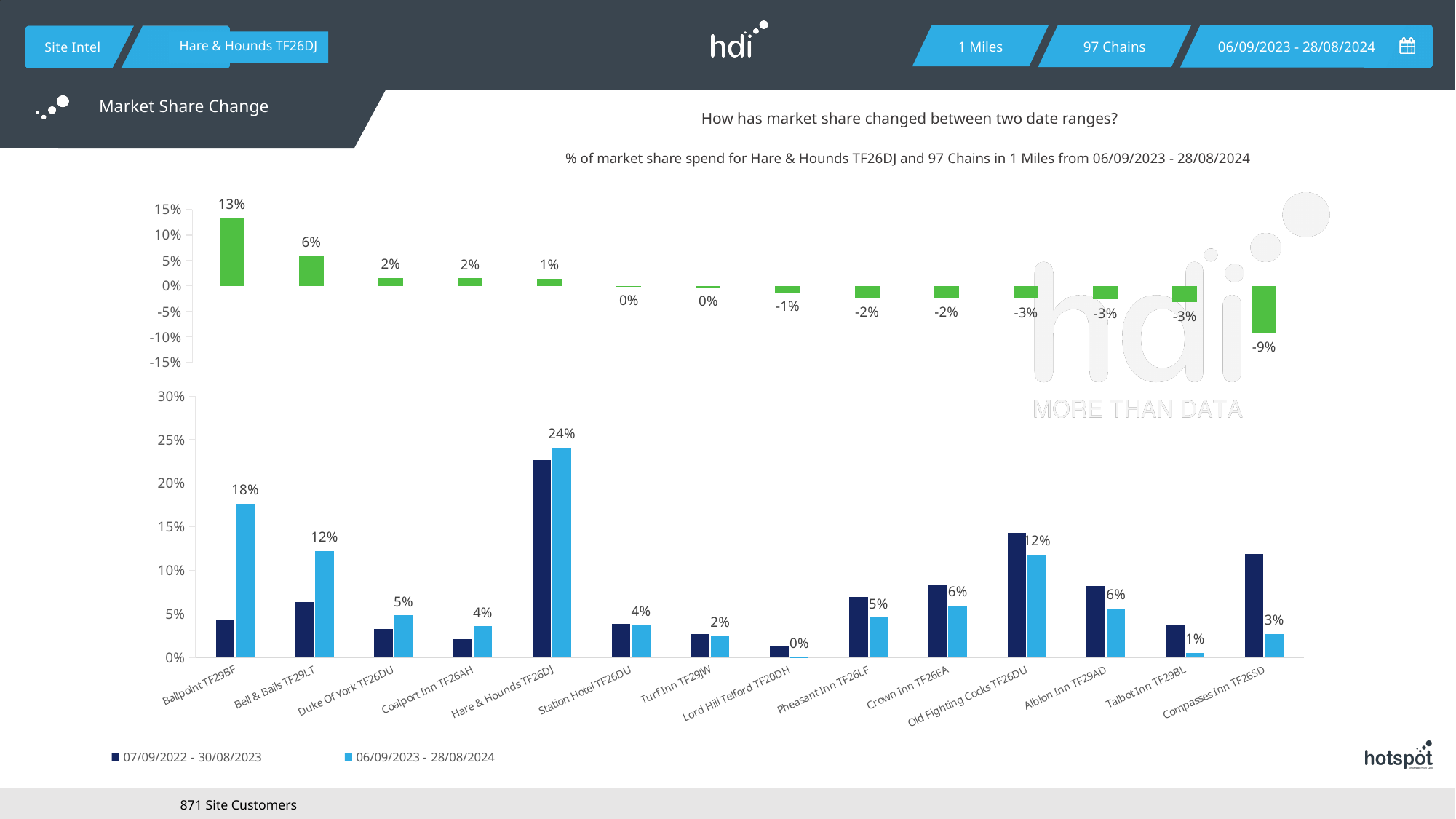
In the top chart (market share change), which category has the highest value? Ballpoint TF29BF How many categories are shown on the x axis of the bottom chart? 14 How many series does the legend of the bottom chart list? 2 In the bottom chart, is the value for Compasses Inn TF26SD in the 07/09/2022 - 30/08/2023 series greater or less than 10%? greater In the bottom chart, what is the value for Old Fighting Cocks TF26DU in the 06/09/2023 - 28/08/2024 series? 12% In the top chart (market share change), do the values rise or fall moving from left to right along the x axis? fall In the bottom chart, what is the value for Hare & Hounds TF26DJ in the 06/09/2023 - 28/08/2024 series? 24% In the bottom chart, which is larger in the 06/09/2023 - 28/08/2024 series: Ballpoint TF29BF or Bell & Bails TF29LT? Ballpoint TF29BF In the top chart (market share change), which category has the lowest value? Compasses Inn TF26SD In the top chart (market share change), what is the value for Ballpoint TF29BF? 13% What kind of chart is the bottom chart? bar chart In the top chart (market share change), what is the difference between the values for Ballpoint TF29BF and Bell & Bails TF29LT? 7 percentage points